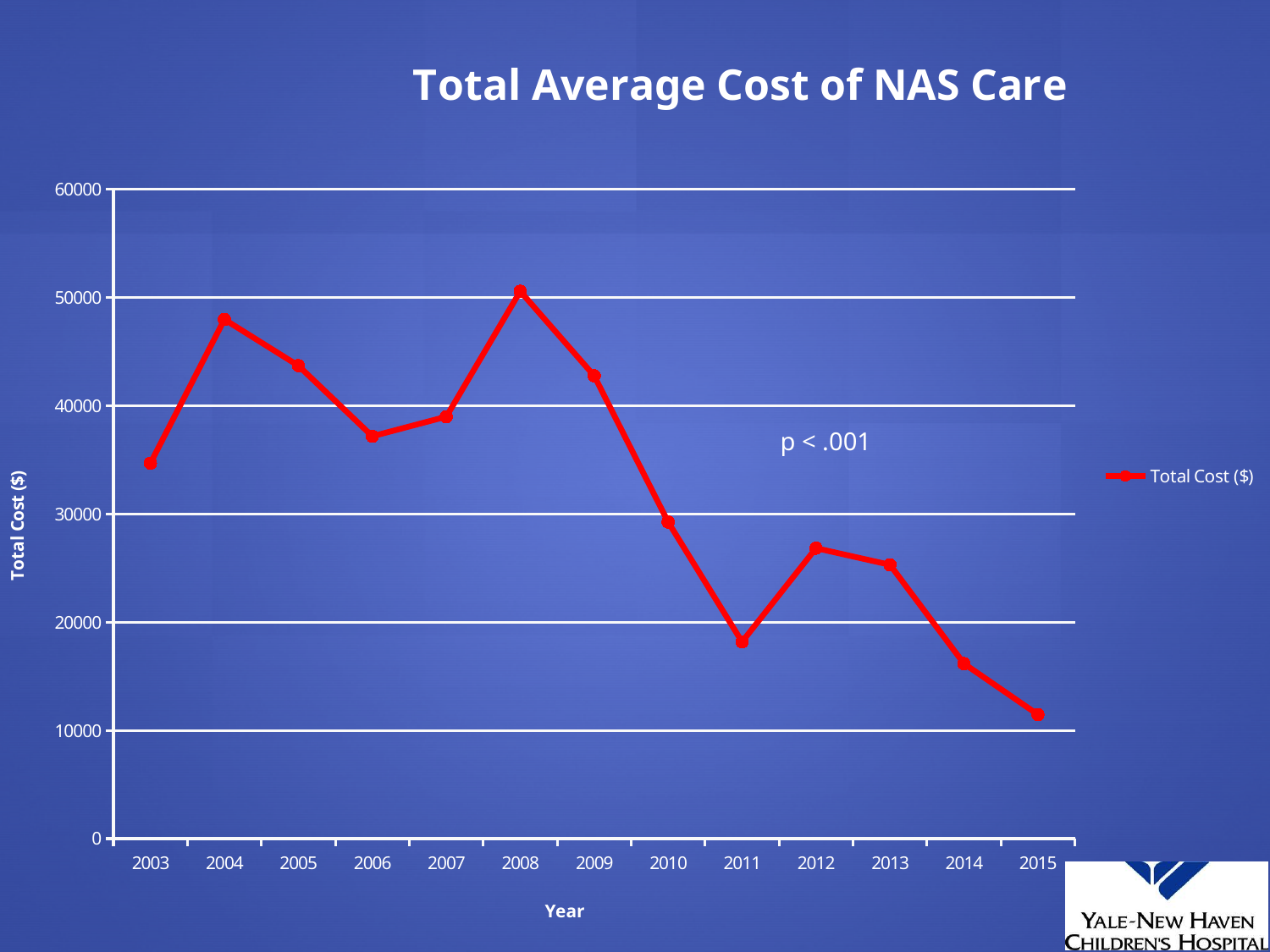
What kind of chart is shown on the slide? Line chart Is the value for 2004 greater or less than 40000? greater How many years are plotted on the x axis? 13 Which year has the highest total average cost of NAS care? 2008 Which year has a higher total cost, 2004 or 2006? 2004 Is the value for 2011 greater or less than 20000? less Which year has the lowest total average cost of NAS care? 2015 Which year has a higher total cost, 2011 or 2012? 2012 How many series does the legend list? 1 Is the value for 2015 greater or less than 10000? greater Does the total cost rise or fall from 2008 to 2015 overall? Fall